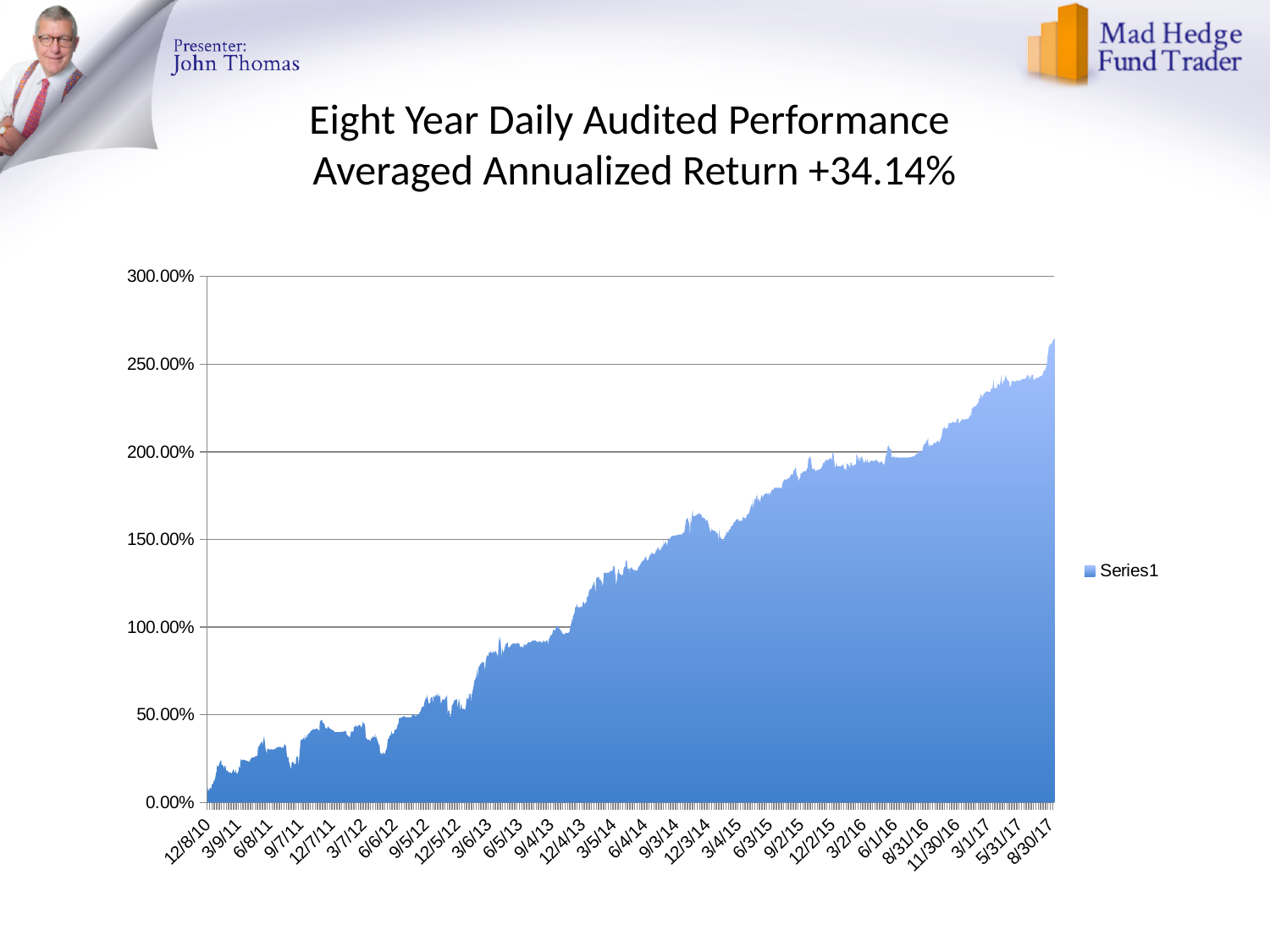
Which of the two dates has the larger value, 6/6/12 or 6/5/13? 6/5/13 Do the values generally rise or fall from 12/8/10 to 8/30/17? rise Is the value at 3/7/12 greater or less than 50.00%? less How many series does the legend list? 1 What kind of chart is shown on the slide? area chart What is the name of the series shown in the legend? Series1 Is the value at 8/30/17 greater or less than 250.00%? greater Is the value at 3/1/17 greater or less than 250.00%? less What is the highest value shown on the vertical axis? 300.00%